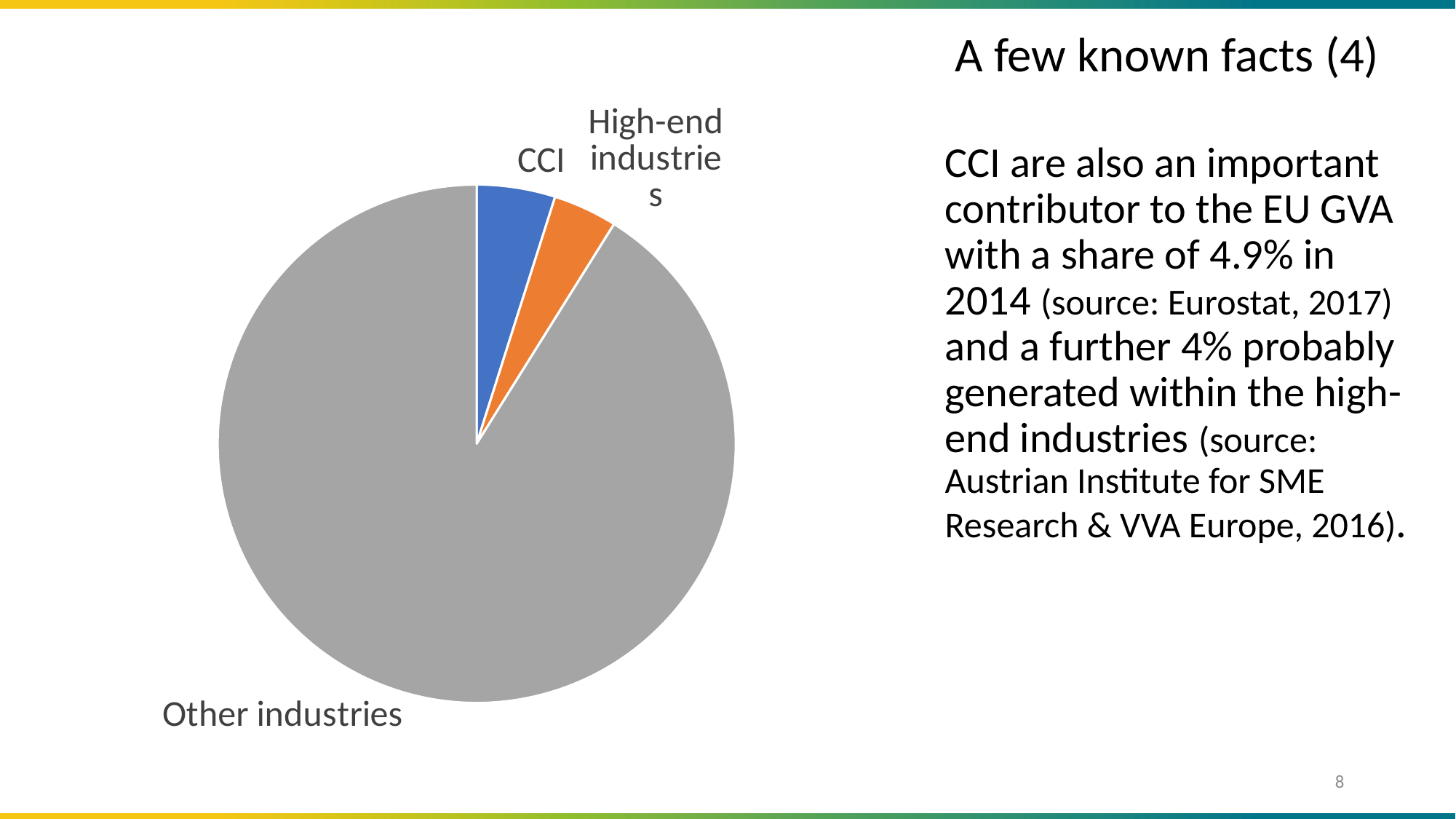
What colour is the Other industries slice in the pie chart? grey Which slice is larger in the pie chart, Other industries or CCI? Other industries How many slices does the pie chart have? 3 Which slice is larger in the pie chart, High-end industries or Other industries? Other industries Which category has the largest slice in the pie chart? Other industries What colour is the CCI slice in the pie chart? blue What kind of chart is shown on the slide? pie chart